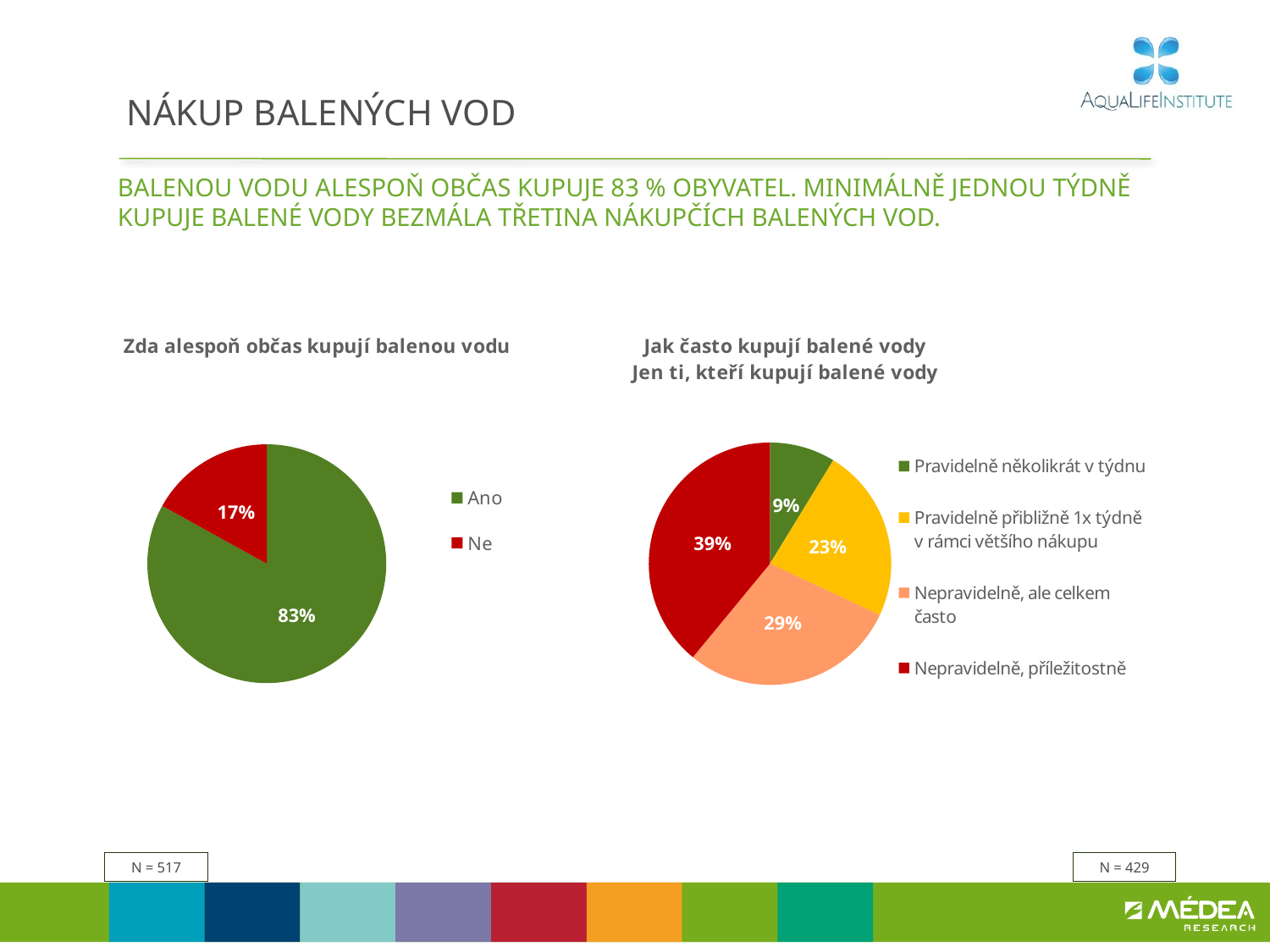
In the right chart 'Jak často kupují balené vody', which is larger: 'Pravidelně přibližně 1x týdně v rámci většího nákupu' or 'Nepravidelně, ale celkem často'? Nepravidelně, ale celkem často In the left chart 'Zda alespoň občas kupují balenou vodu', what is the difference between the 'Ano' and 'Ne' shares? 66% In the left chart 'Zda alespoň občas kupují balenou vodu', what share is labelled 'Ano'? 83% In the right chart 'Jak často kupují balené vody', what is the difference between 'Nepravidelně, ale celkem často' and 'Pravidelně přibližně 1x týdně v rámci většího nákupu'? 6% In the right chart 'Jak často kupují balené vody', what share is 'Pravidelně několikrát v týdnu'? 9% In the right chart 'Jak často kupují balené vody', what share is 'Nepravidelně, příležitostně'? 39% In the left chart 'Zda alespoň občas kupují balenou vodu', how many categories does the legend list? 2 In the right chart 'Jak často kupují balené vody', which category has the largest share? Nepravidelně, příležitostně In the right chart 'Jak často kupují balené vody', how many categories does the legend list? 4 In the left chart 'Zda alespoň občas kupují balenou vodu', what type of chart is shown? pie chart In the left chart 'Zda alespoň občas kupují balenou vodu', what share is labelled 'Ne'? 17% In the right chart 'Jak často kupují balené vody', which category has the smallest share? Pravidelně několikrát v týdnu